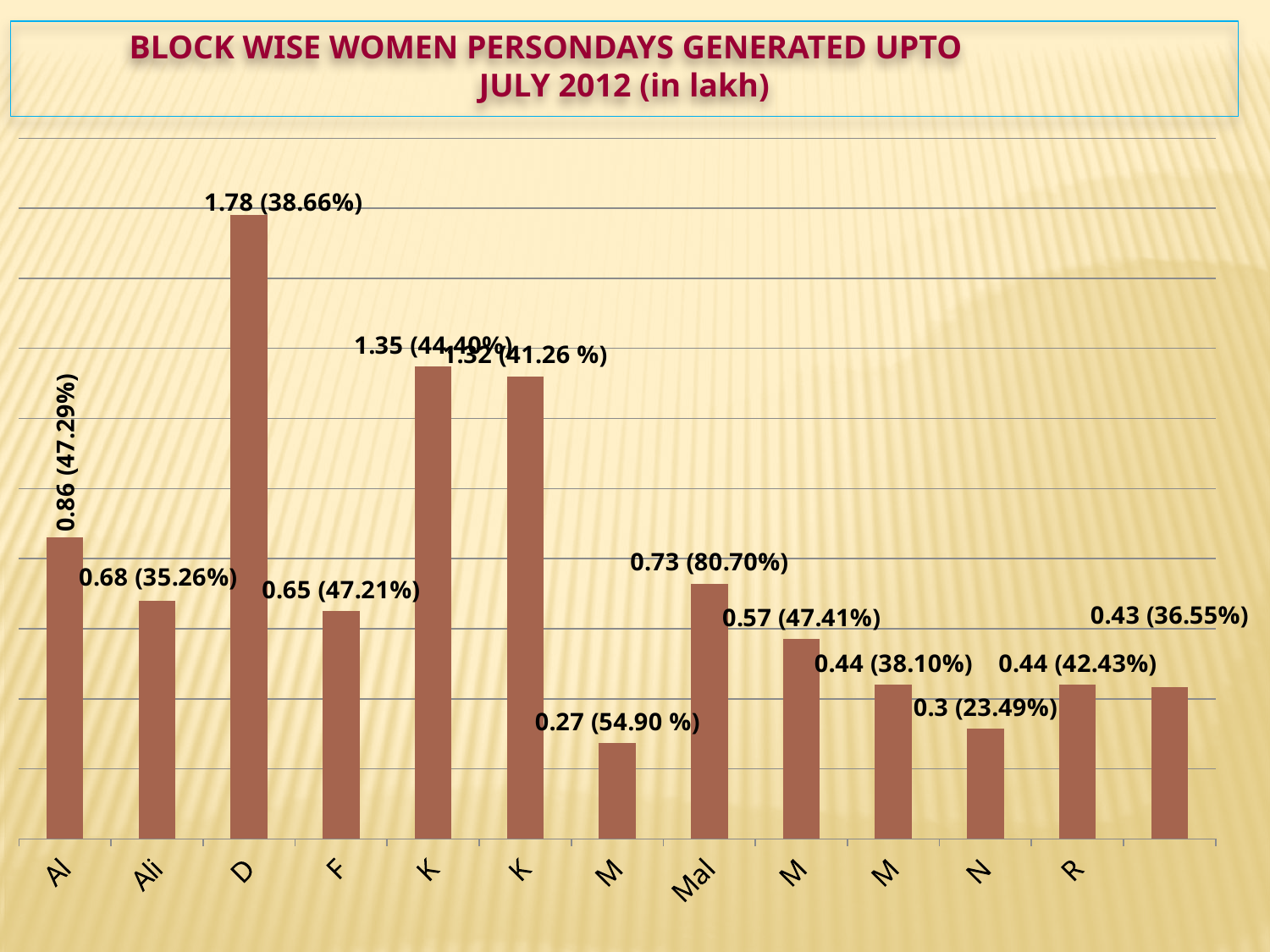
Which block has the highest women persondays value? D What is the difference in lakh between the values for block D and block Al? 0.92 What is the data label on the bar for block Mal? 0.73 (80.70%) Which block has the larger value, Al or Ali? Al What is the data label on the bar for block D? 1.78 (38.66%) What is the data label on the bar for block N? 0.3 (23.49%) What is the data label on the bar for block F? 0.65 (47.21%) How many bars are plotted in the chart? 13 What is the lowest data label value shown in the chart? 0.27 (54.90 %) What is the title of the chart? BLOCK WISE WOMEN PERSONDAYS GENERATED UPTO JULY 2012 (in lakh) What kind of chart is shown on the slide? bar chart What is the data label on the bar for block Al? 0.86 (47.29%)